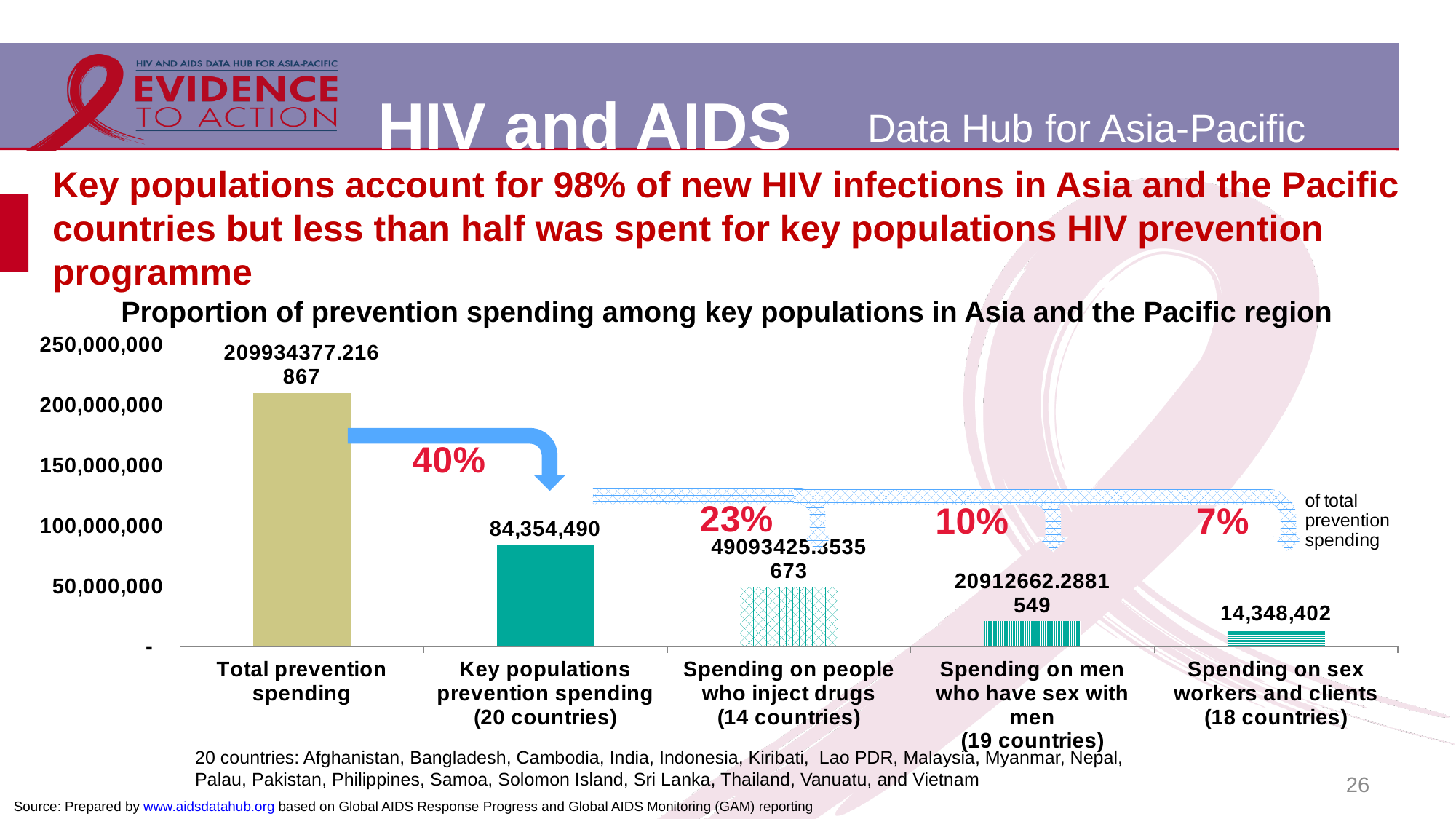
Which category has the lowest value? Spending on sex workers and clients (18 countries) Is the value for Spending on men who have sex with men greater or less than 50,000,000? less How many categories are shown on the x axis of the chart? 5 What is the difference between Key populations prevention spending and Spending on sex workers and clients? 70,006,088 What is the value for Key populations prevention spending (20 countries)? 84,354,490 Which category has the highest value? Total prevention spending What is the value for Spending on sex workers and clients (18 countries)? 14,348,402 What kind of chart is shown on the slide? bar chart Which is larger: Key populations prevention spending or Spending on people who inject drugs? Key populations prevention spending Is the value for Total prevention spending greater or less than 200,000,000? greater Do the bar values rise or fall from left to right along the x axis? fall What is the value for Total prevention spending? 209934377.216867